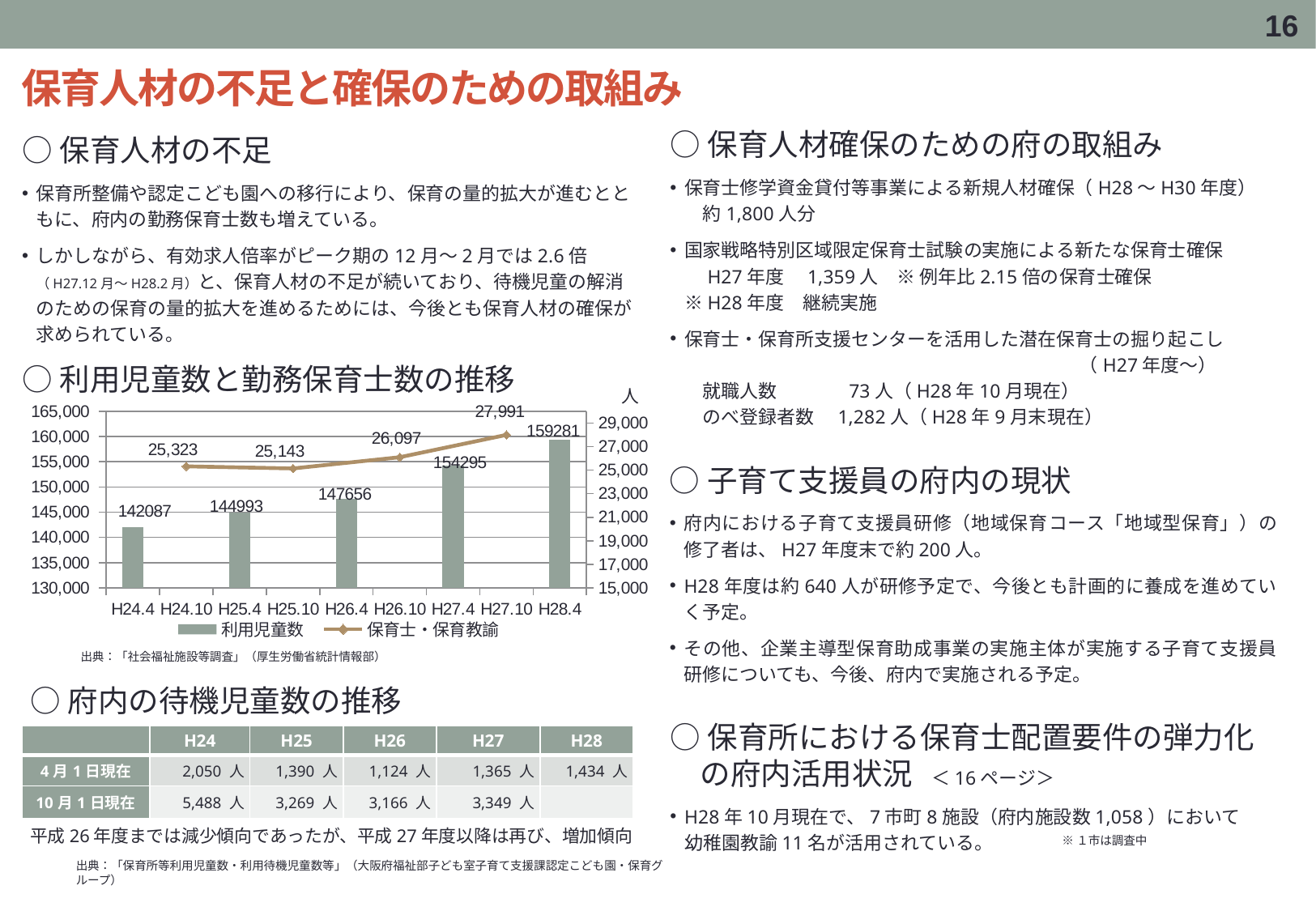
What is the difference in 利用児童数 between H28.4 and H27.4? 4986 What is the value of 利用児童数 for H24.4? 142087 What is the value of 利用児童数 for H28.4? 159281 Which period has the lowest value of 保育士・保育教諭? H25.10 How many bars are plotted for 利用児童数? 5 Do the 利用児童数 values rise or fall from H24.4 to H28.4? rise How many series does the legend list? 2 Which period has the highest value of 利用児童数? H28.4 What kind of chart is used to show 利用児童数? bar chart